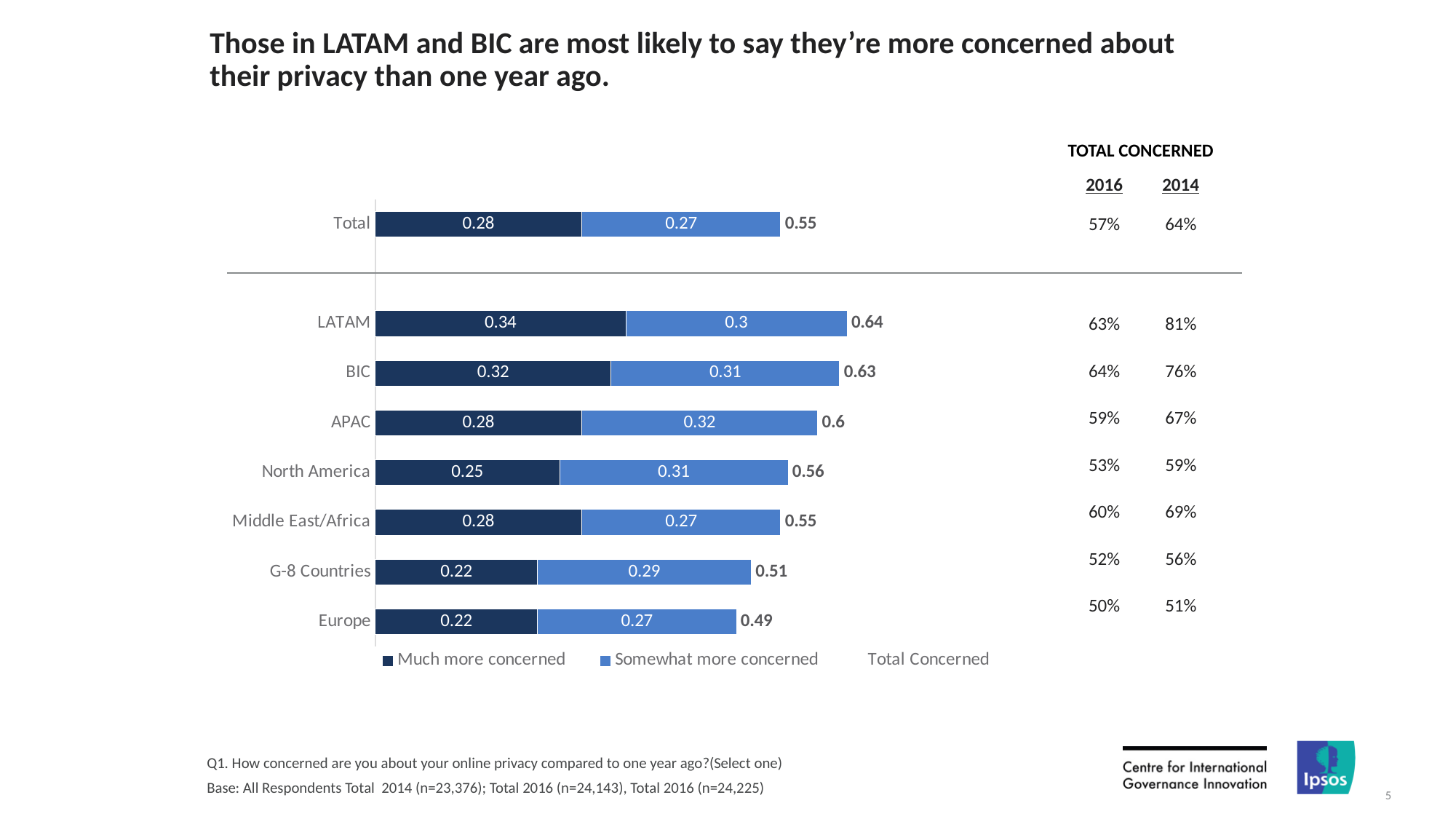
What is the total of the stacked bar for BIC? 0.63 What kind of chart is shown on the slide? Stacked bar chart What is the difference between the 'Much more concerned' values for LATAM and Europe? 0.12 Which is larger, the 'Somewhat more concerned' value for North America or for Middle East/Africa? North America What is the Total Concerned value shown for Europe? 0.49 How many region categories are plotted below the Total bar? 7 What is the 'Somewhat more concerned' value for APAC? 0.32 Which region has the highest Total Concerned value in the bar chart? LATAM How many series does the legend list? 3 Which legend entry is shown in dark navy blue? Much more concerned What is the 'Much more concerned' value for LATAM? 0.34 Which region has the lowest Total Concerned value in the bar chart? Europe